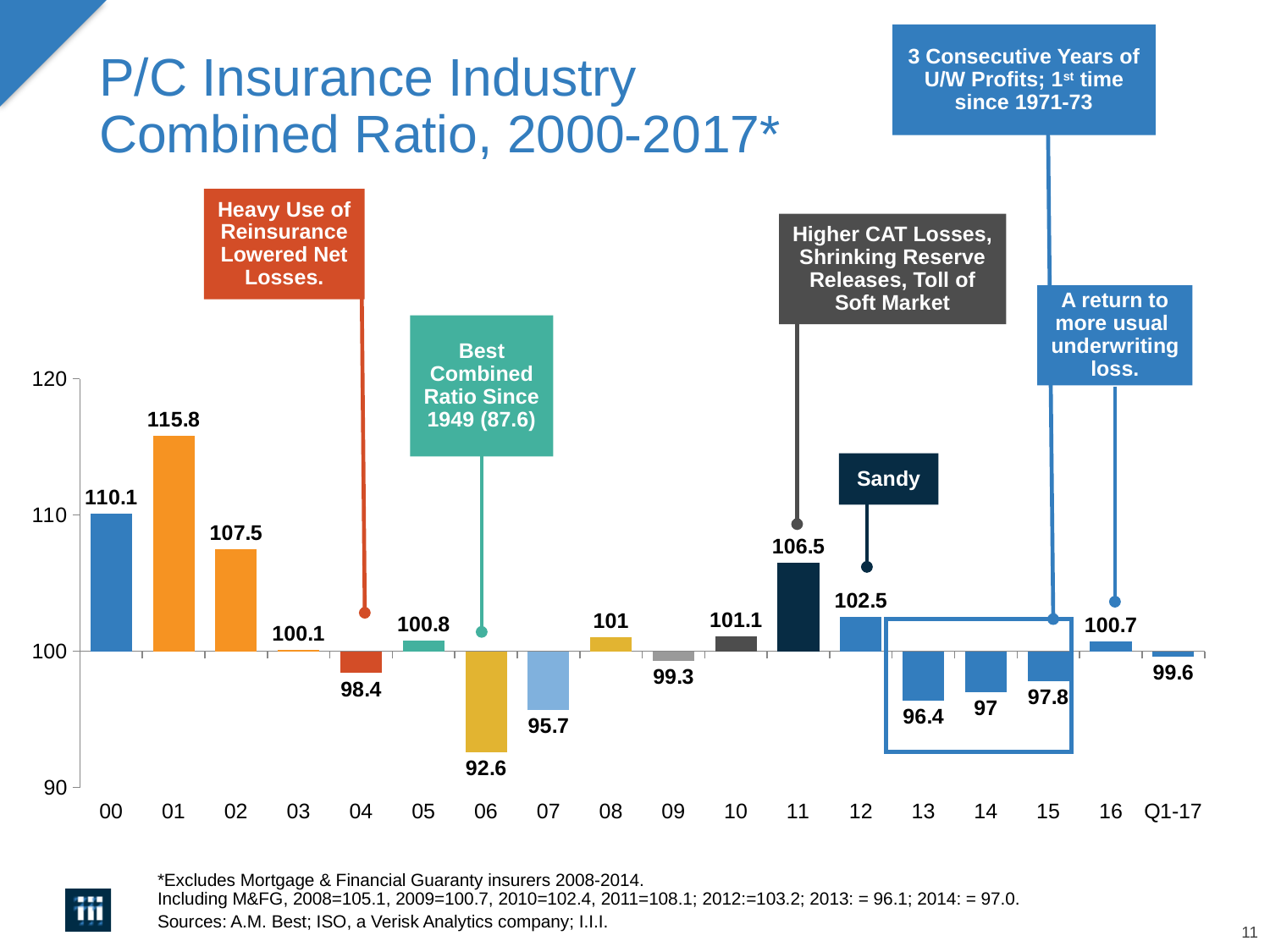
Which year has a higher combined ratio, 2002 or 2011? 02 Is the combined ratio for 2000 greater or less than 110? greater Which year has the highest combined ratio? 01 What is the difference between the combined ratio in 2011 and in 2012? 4 What is the combined ratio for 2006? 92.6 How many bars are plotted in the chart? 18 Which year's bar is labelled with the callout 'Sandy'? 12 Which year has the lowest combined ratio? 06 What is the combined ratio for 2001? 115.8 What kind of chart is shown on the slide? bar chart What is the combined ratio for Q1-17? 99.6